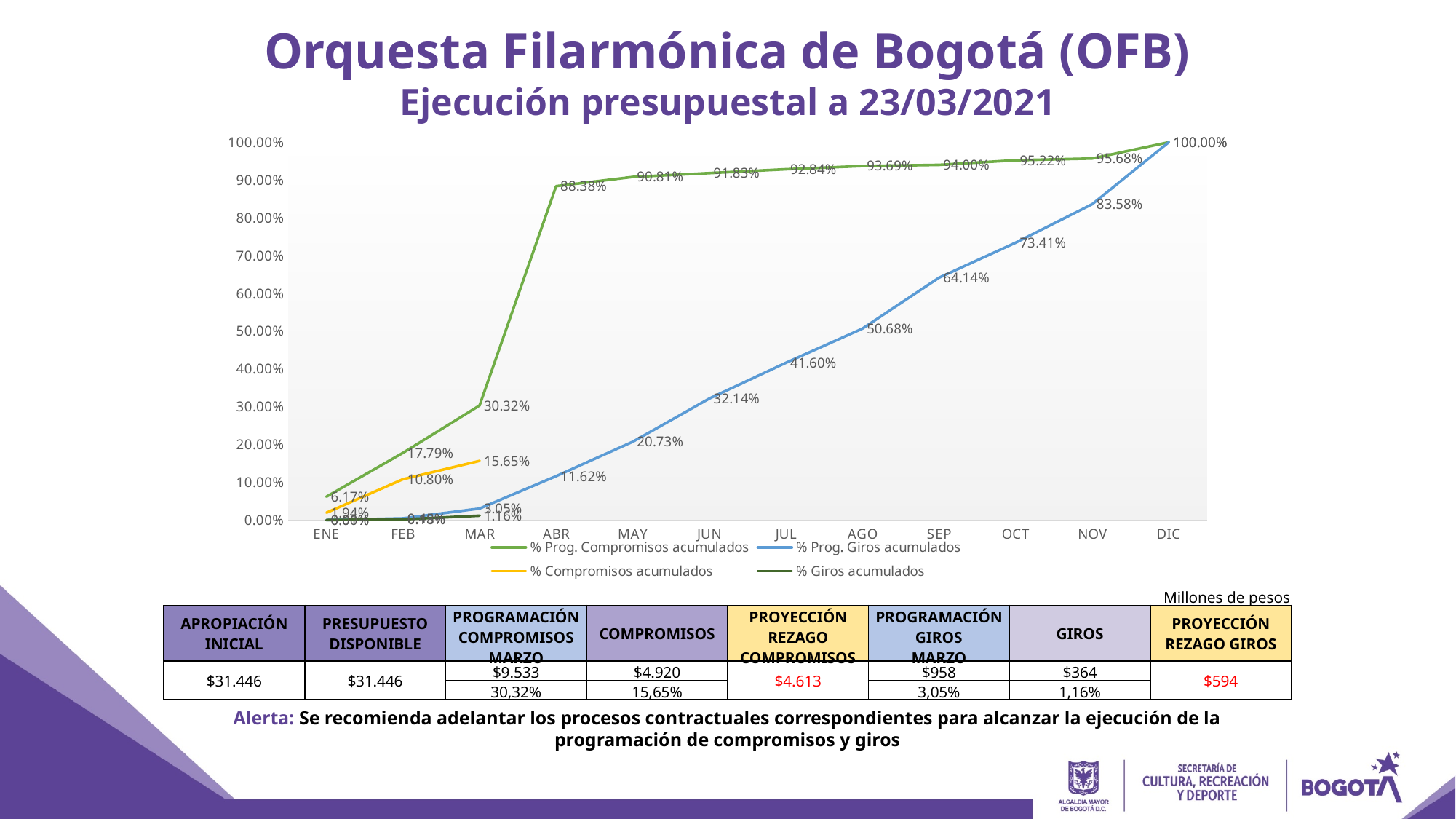
How many series does the chart legend list? 4 What type of chart is shown on the slide? Line chart Does the % Prog. Giros acumulados line rise or fall from ENE to DIC? Rise What colour is the % Prog. Giros acumulados line in the chart? Blue In which month does % Prog. Compromisos acumulados reach its highest value? DIC How many months are shown along the x axis of the chart? 12 What is the value of % Giros acumulados in MAR? 1.16% What is the difference between % Prog. Compromisos acumulados and % Compromisos acumulados in MAR? 14.67 percentage points What is the value of % Prog. Compromisos acumulados in ABR? 88.38% What is the value of % Prog. Giros acumulados in SEP? 64.14% What is the value of % Compromisos acumulados in MAR? 15.65% In JUL, which is larger: % Prog. Compromisos acumulados or % Prog. Giros acumulados? % Prog. Compromisos acumulados